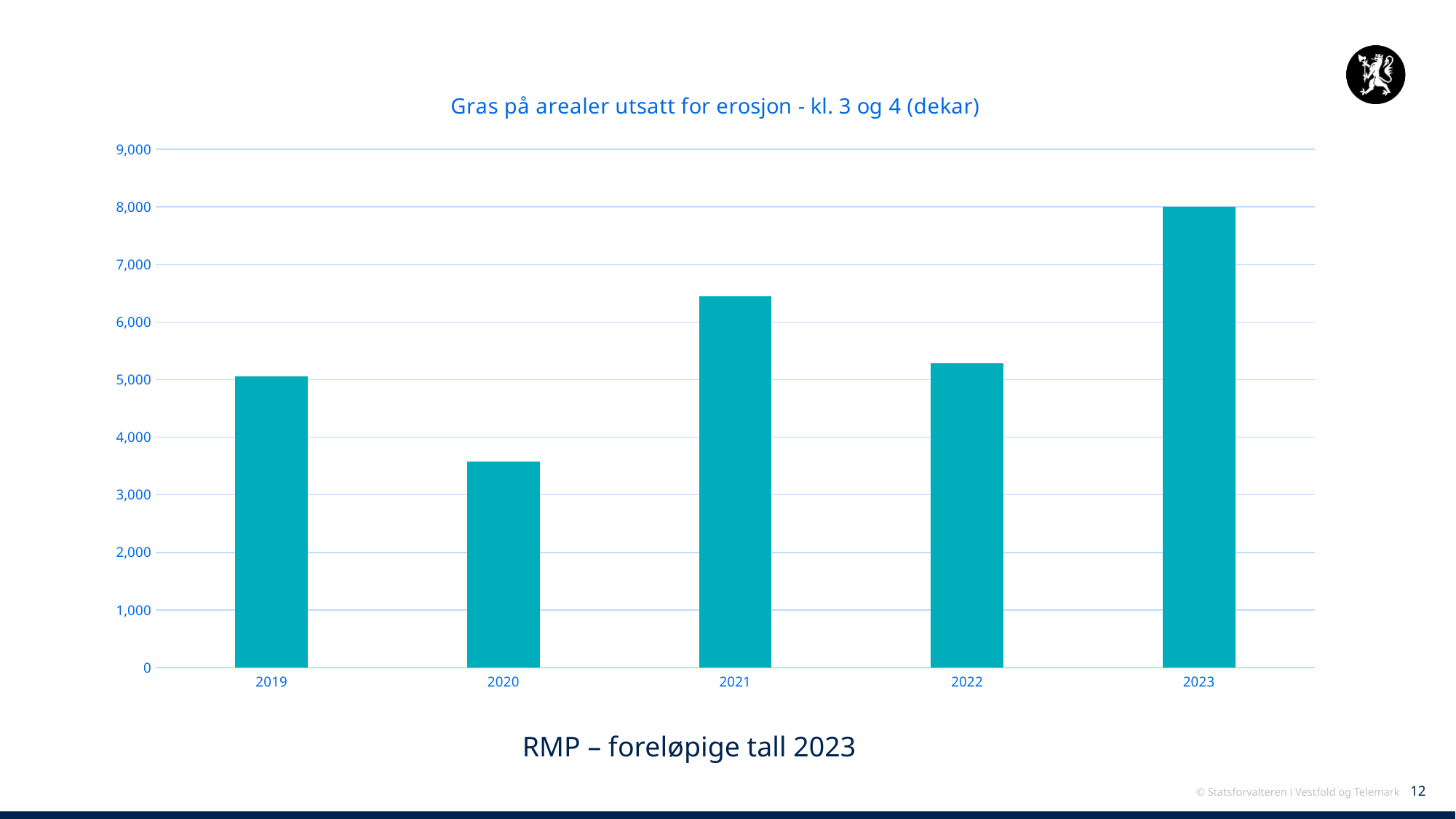
What is the title of the chart? Gras på arealer utsatt for erosjon - kl. 3 og 4 (dekar) Which year has the larger value, 2020 or 2019? 2019 Which year has the larger value, 2021 or 2022? 2021 How many years are shown on the x axis of the chart? 5 Is the value for 2023 greater or less than 7,000? greater Is the value for 2019 greater or less than 6,000? less Is the value for 2020 greater or less than 4,000? less What type of chart is shown on the slide? bar chart Which year has the lowest value in the chart? 2020 Which year has the highest value in the chart? 2023 Did the value rise or fall from 2022 to 2023? rise